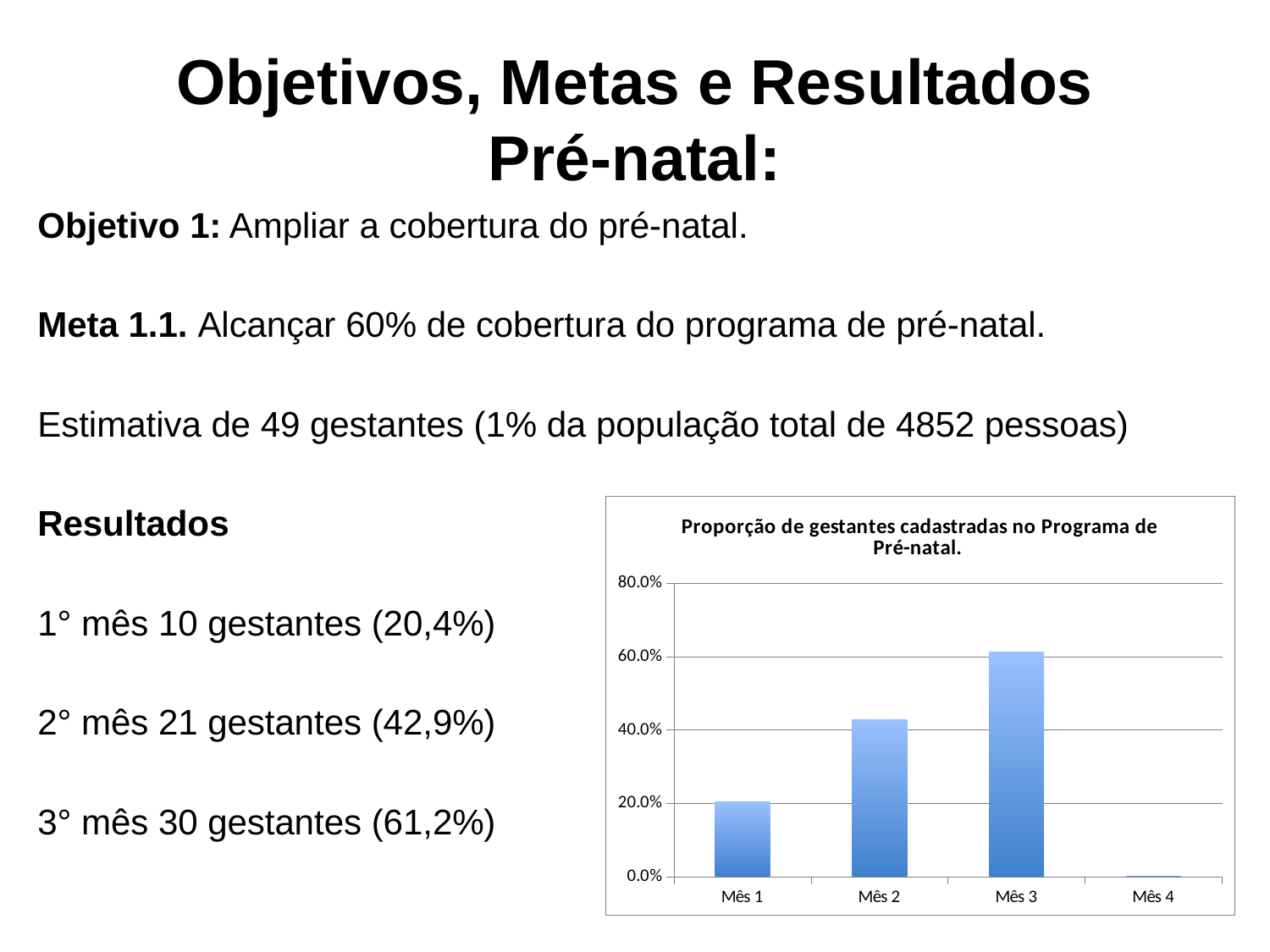
What is the highest value shown on the y axis of the chart? 80.0% Which category has the highest bar in the chart? Mês 3 Is the value for Mês 3 greater or less than 80.0%? less Which is larger, the value for Mês 2 or the value for Mês 3? Mês 3 Which category has the lowest bar in the chart? Mês 4 What is the title of the chart? Proporção de gestantes cadastradas no Programa de Pré-natal. Is the value for Mês 1 greater or less than 40.0%? less Is the value for Mês 2 greater or less than 40.0%? greater How many categories are shown on the x axis of the chart? 4 Do the values rise or fall from Mês 1 to Mês 3? rise What kind of chart is shown on the slide? bar chart